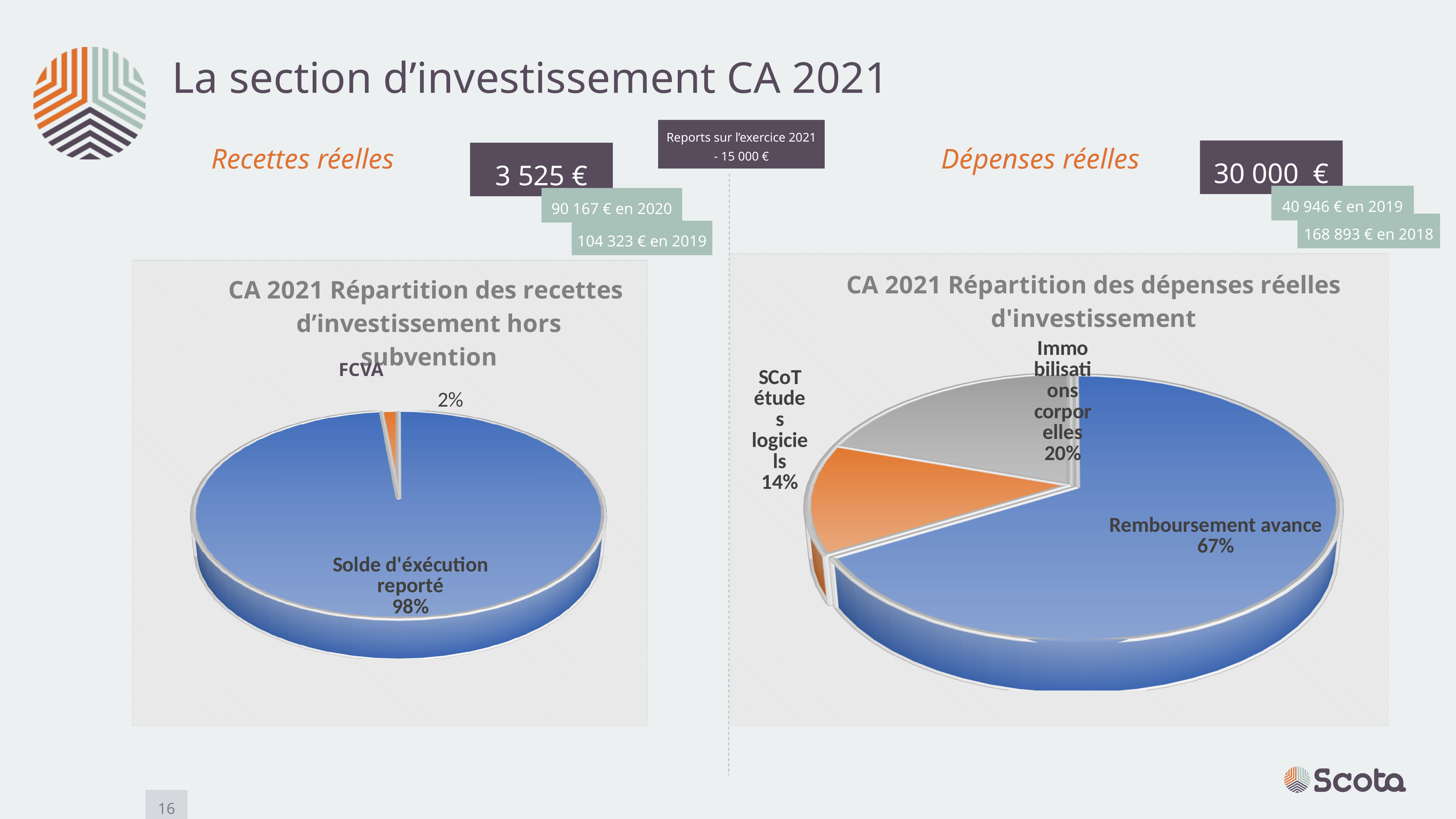
How many slices does the chart 'CA 2021 Répartition des recettes d'investissement hors subvention' have? 2 How many slices does the chart 'CA 2021 Répartition des dépenses réelles d'investissement' have? 3 In the chart 'CA 2021 Répartition des dépenses réelles d'investissement', what share does 'Remboursement avance' have? 67% What kind of chart is 'CA 2021 Répartition des recettes d'investissement hors subvention'? Pie chart In the chart 'CA 2021 Répartition des recettes d'investissement hors subvention', what share does 'Solde d'éxécution reporté' have? 98% In the chart 'CA 2021 Répartition des recettes d'investissement hors subvention', which slice is the largest? Solde d'éxécution reporté In the chart 'CA 2021 Répartition des dépenses réelles d'investissement', which slice is the smallest? SCoT études logiciels In the chart 'CA 2021 Répartition des dépenses réelles d'investissement', which is larger: 'Immobilisations corporelles' or 'SCoT études logiciels'? Immobilisations corporelles In the chart 'CA 2021 Répartition des dépenses réelles d'investissement', what share does 'Immobilisations corporelles' have? 20% In the chart 'CA 2021 Répartition des dépenses réelles d'investissement', what is the difference in percentage points between 'Remboursement avance' and 'Immobilisations corporelles'? 47